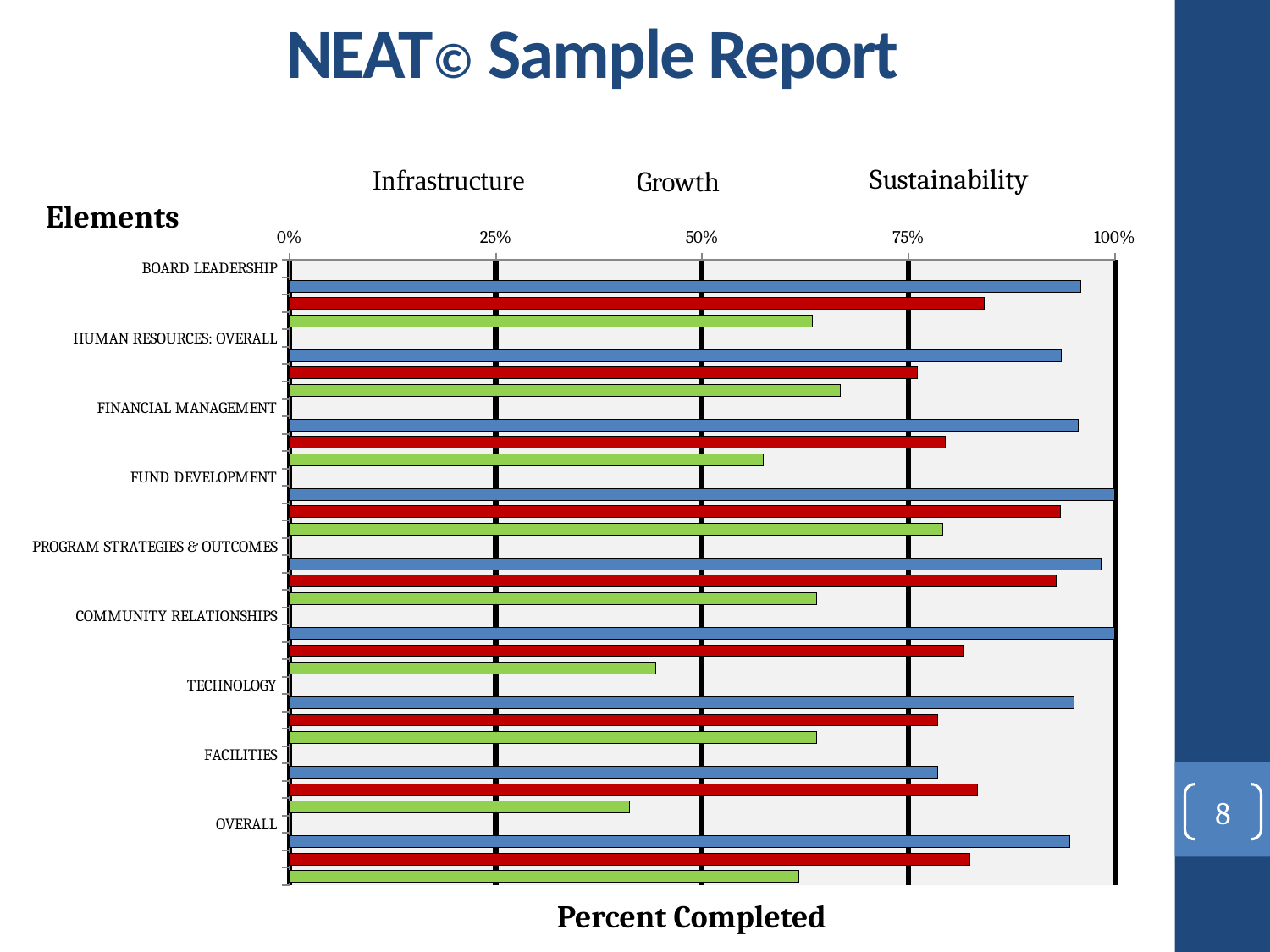
Which is larger, the green bar for BOARD LEADERSHIP or the green bar for FACILITIES? BOARD LEADERSHIP What kind of chart is shown on the slide? Bar chart Which three series names are shown above the chart? Infrastructure, Growth, Sustainability Is the blue bar for FUND DEVELOPMENT greater or less than 75%? greater Which category has the highest green bar? FUND DEVELOPMENT What is the title of the horizontal axis of the chart? Percent Completed Is the green bar for BOARD LEADERSHIP greater or less than 50%? greater Is the green bar for OVERALL greater or less than 75%? less Which category has the lowest blue bar? FACILITIES How many element categories are listed on the vertical axis of the chart? 9